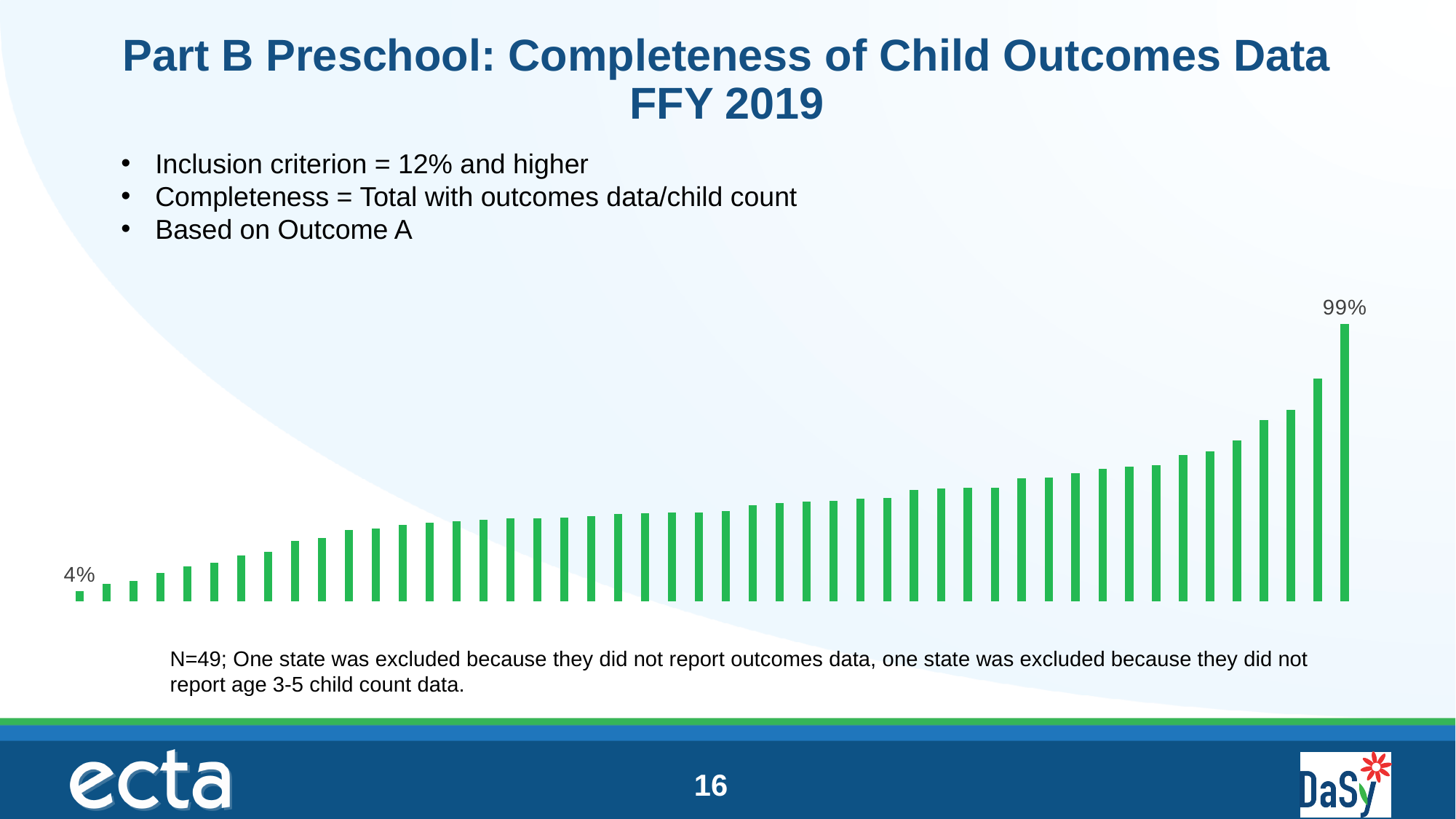
Do the bar values rise or fall from left to right across the chart? rise What is the difference between the highest and lowest values labelled on the chart? 95 percentage points Is the rightmost bar larger or smaller than the leftmost bar? larger What kind of chart is shown on the slide? bar chart What is the lowest completeness value shown on the chart? 4% What value is labelled on the rightmost bar of the chart? 99% What value is labelled on the leftmost bar of the chart? 4% What is the highest completeness value shown on the chart? 99% What colour are the bars in the chart? green What fiscal year does the slide title say the completeness data is for? FFY 2019 How many states (bars) are represented in the chart, according to the note below it? 49